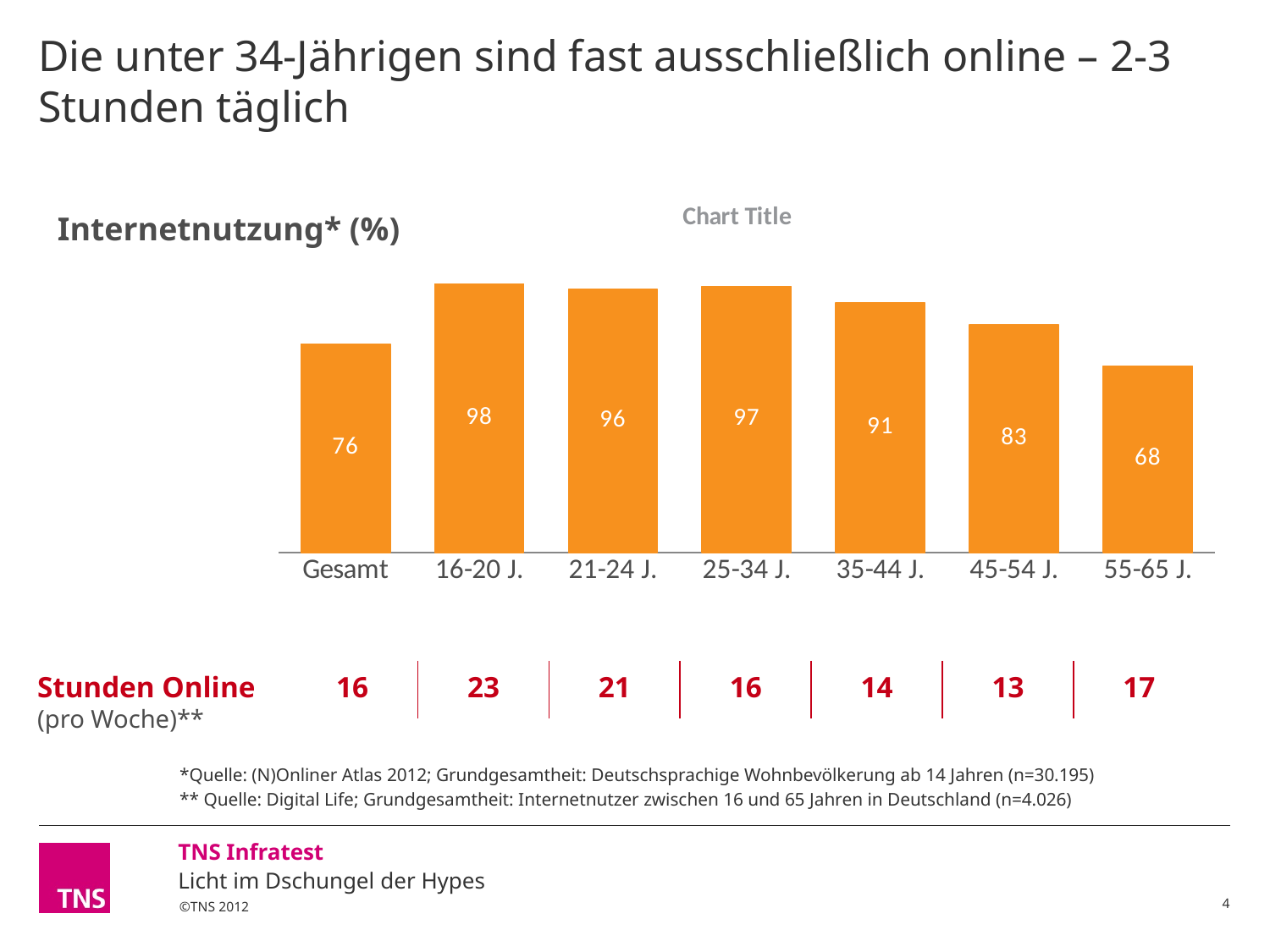
What is the value for the 35-44 J. age group in the Internetnutzung chart? 91 Which is larger in the Internetnutzung chart, the value for 25-34 J. or the value for 35-44 J.? 25-34 J. What is the value for the 55-65 J. age group in the Internetnutzung chart? 68 What is the value for the 16-20 J. age group in the Internetnutzung chart? 98 What is the difference between the values for 16-20 J. and 55-65 J. in the Internetnutzung chart? 30 What is the difference between the values for 45-54 J. and Gesamt in the Internetnutzung chart? 7 Which category has the lowest value in the Internetnutzung chart? 55-65 J. What is the value for Gesamt in the Internetnutzung chart? 76 How many categories are shown on the x axis of the Internetnutzung chart? 7 Do the values in the Internetnutzung chart rise or fall from 16-20 J. to 55-65 J.? Fall What kind of chart is used to show Internetnutzung? Bar chart Which category has the highest value in the Internetnutzung chart? 16-20 J.